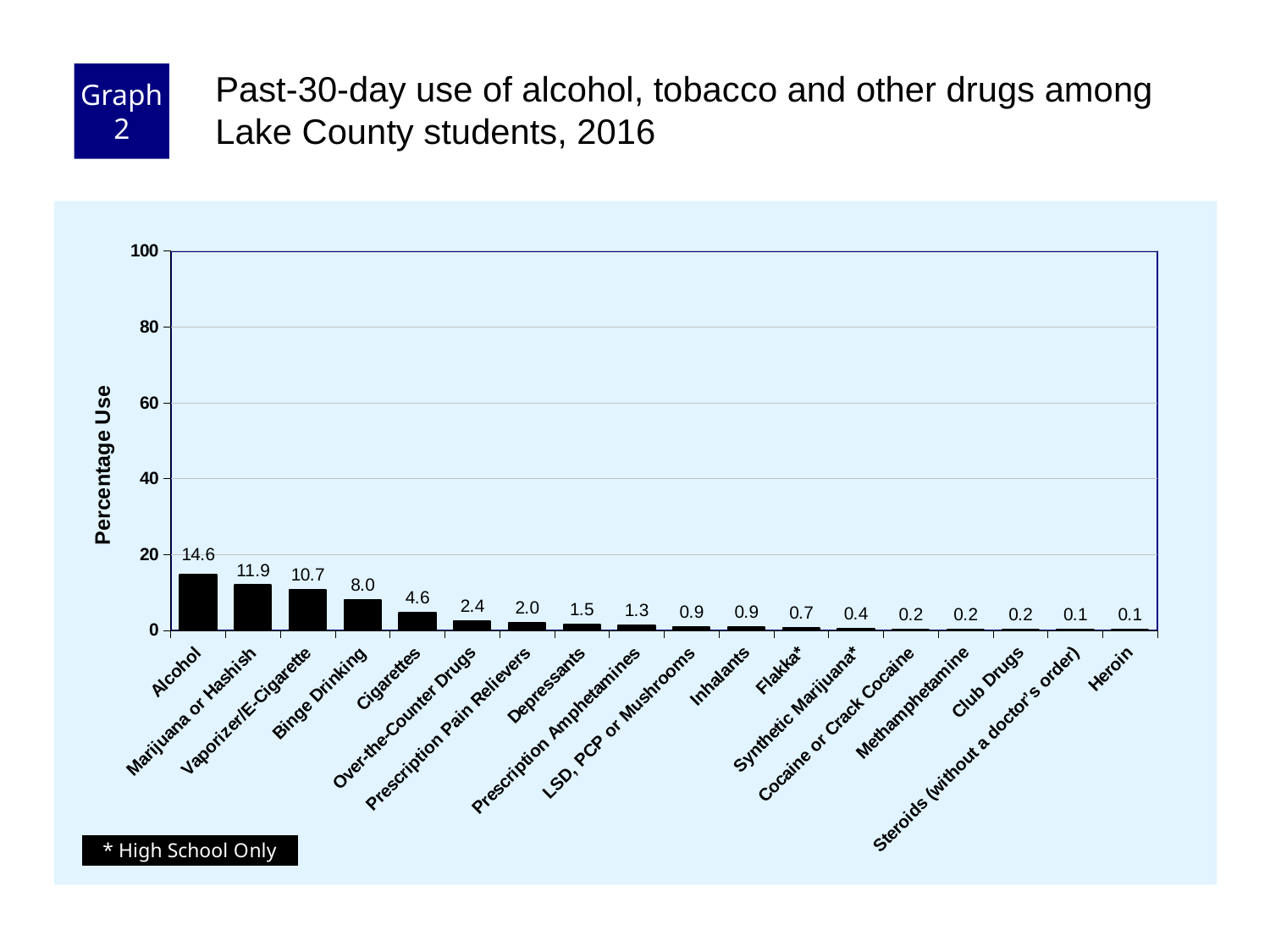
What kind of chart is shown on the slide? bar chart What is the difference in percentage use between Binge Drinking and Cigarettes? 3.4 Which category has the highest percentage use? Alcohol What is the percentage use for Flakka*? 0.7 What is the difference in percentage use between Alcohol and Marijuana or Hashish? 2.7 What is the percentage use for Alcohol? 14.6 What is the label of the y axis? Percentage Use What is the percentage use for Vaporizer/E-Cigarette? 10.7 Which has a higher percentage use, Over-the-Counter Drugs or Depressants? Over-the-Counter Drugs What is the percentage use for Cigarettes? 4.6 How many categories are shown on the x axis? 18 Is the value for Alcohol greater or less than 20? less